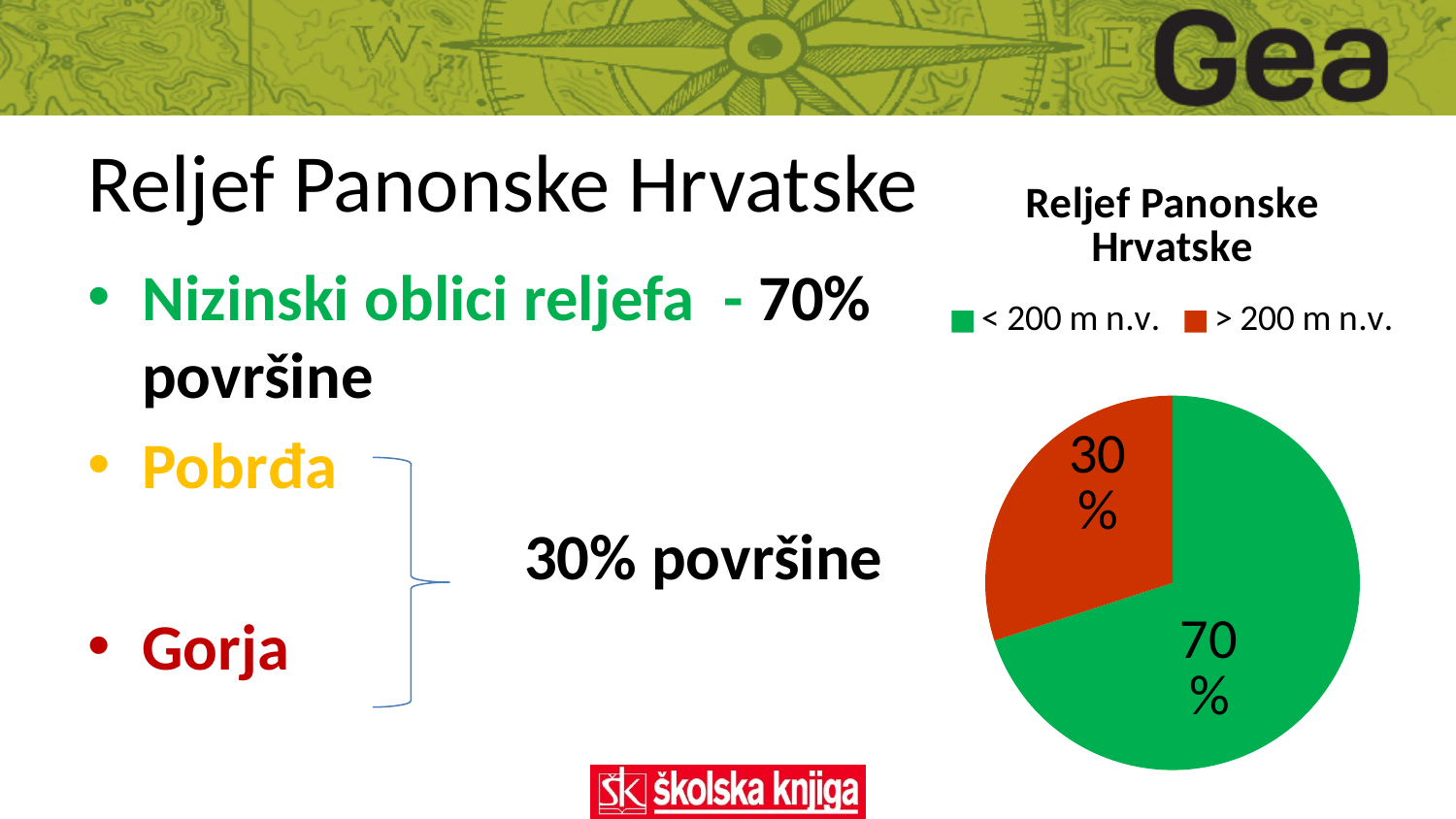
Which category has the smallest slice of the pie? > 200 m n.v. What is the title of the chart? Reljef Panonske Hrvatske What is the difference between the '< 200 m n.v.' share and the '> 200 m n.v.' share? 40% How many entries does the legend list? 2 What colour is the '> 200 m n.v.' slice? red What share of the pie does the '> 200 m n.v.' slice take? 30% What kind of chart is shown on the slide? pie chart What share of the pie does the '< 200 m n.v.' slice take? 70% Which category has the largest slice of the pie? < 200 m n.v. How many slices does the pie chart have? 2 Which is larger, the '< 200 m n.v.' slice or the '> 200 m n.v.' slice? < 200 m n.v.